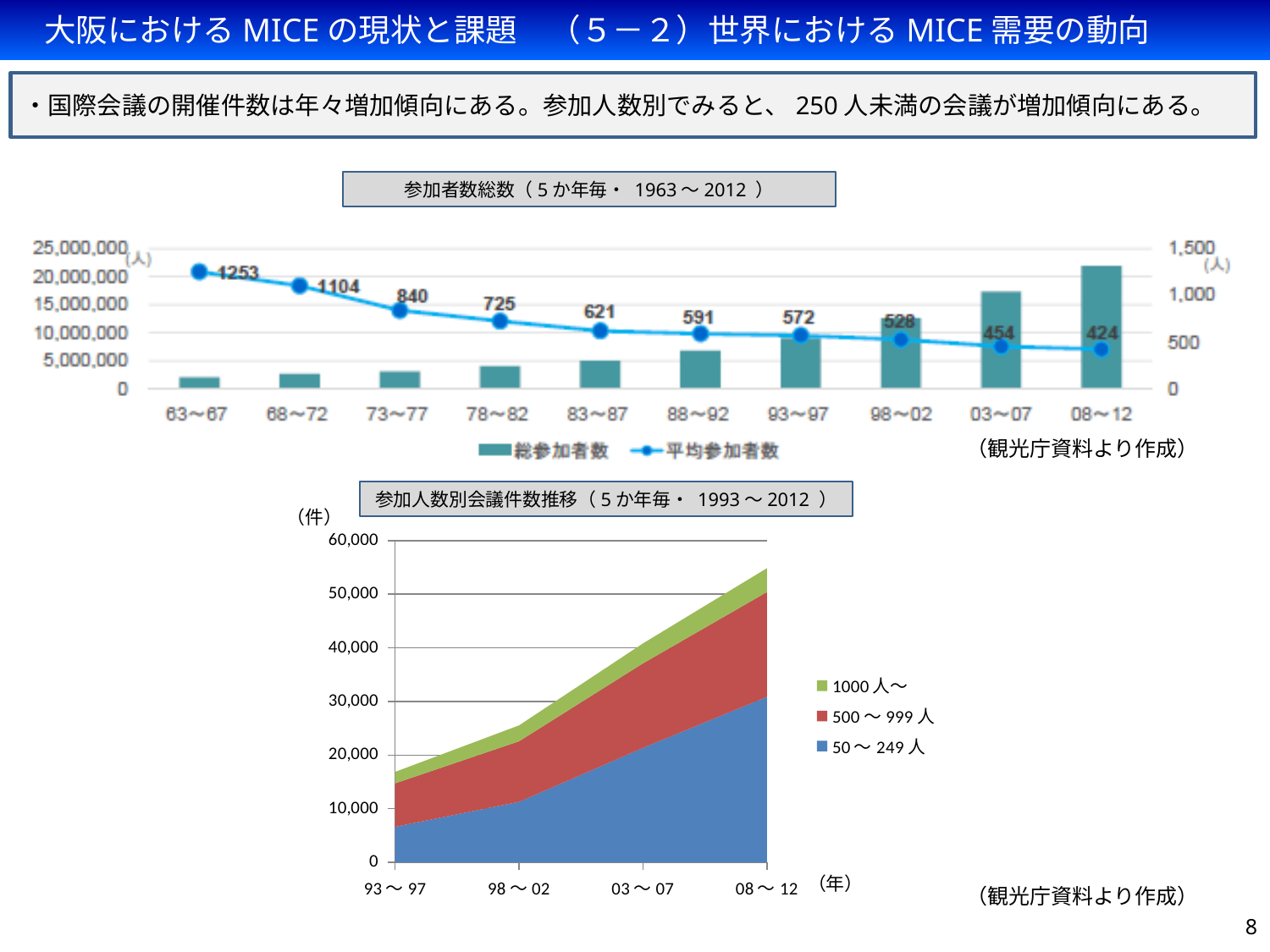
In the top chart (参加者数総数), does 平均参加者数 rise or fall from 63～67 to 08～12? fall What kind of chart is the bottom chart (参加人数別会議件数推移)? Stacked area chart In the top chart (参加者数総数), what is the difference in 平均参加者数 between 63～67 and 08～12? 829 In the top chart (参加者数総数), which period has a larger 平均参加者数, 73～77 or 78～82? 73～77 In the top chart (参加者数総数), is the 総参加者数 bar for 08～12 greater or less than 20,000,000? greater In the top chart (参加者数総数), what is the value of 平均参加者数 for 08～12? 424 In the top chart (参加者数総数), how many series does the legend list? 2 In the top chart (参加者数総数), which period has the highest 平均参加者数? 63～67 In the top chart (参加者数総数), what is the value of 平均参加者数 for 63～67? 1253 In the bottom chart (参加人数別会議件数推移), is the total number of meetings for 08～12 greater or less than 50,000? greater In the bottom chart (参加人数別会議件数推移), how many series does the legend list? 3 In the top chart (参加者数総数), which period has the lowest 平均参加者数? 08～12